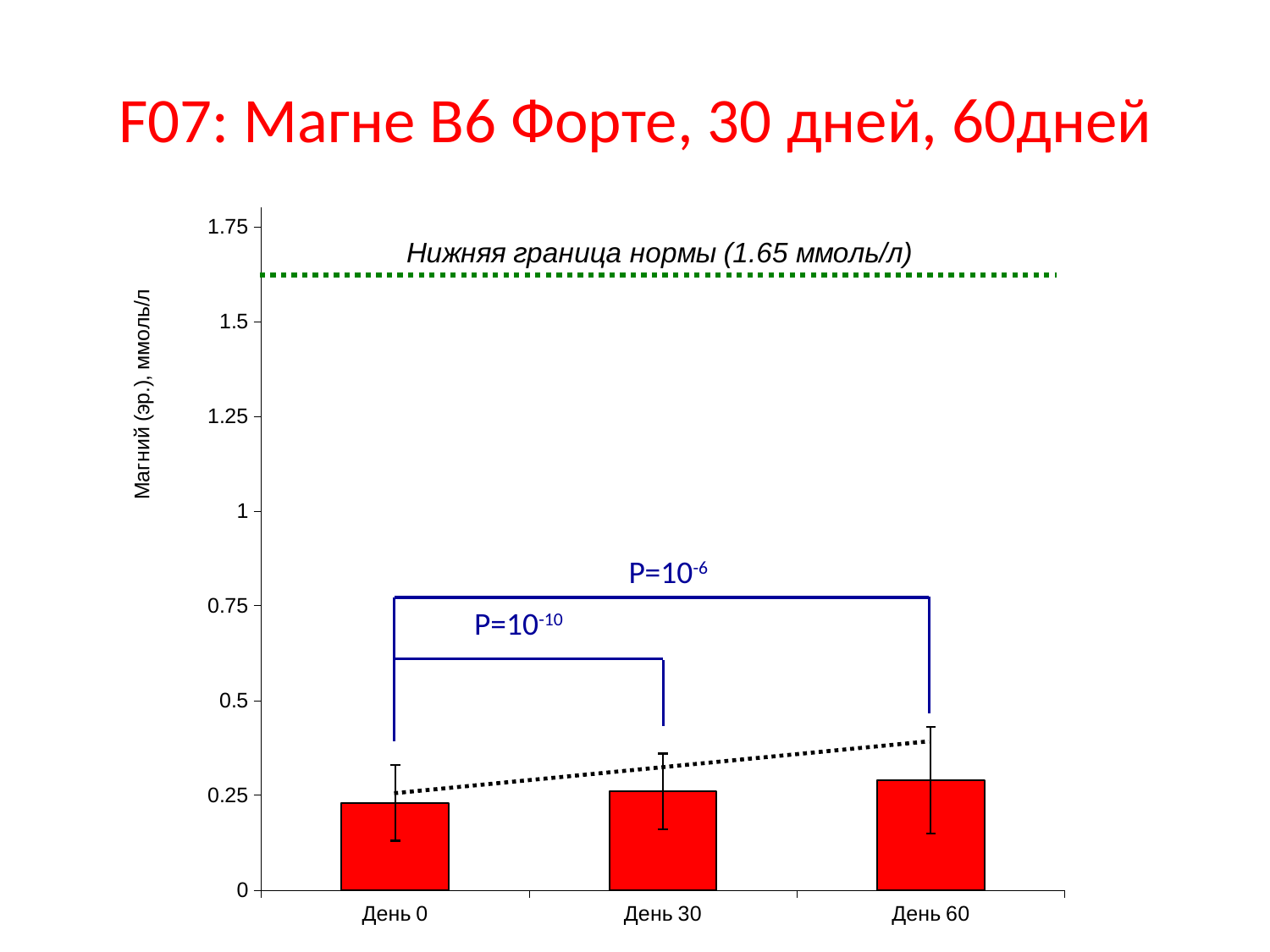
Which is larger, the value for День 0 or the value for День 60? День 60 What P value is shown between День 0 and День 60? P=10^-6 Is the value for День 60 greater or less than 0.5? less What is the y-axis label of the chart? Магний (эр.), ммоль/л What value is given for the lower limit of the norm (Нижняя граница нормы) on the chart? 1.65 ммоль/л Do the bar values rise or fall from День 0 to День 60? rise What kind of chart is shown on the slide? bar chart How many bars (categories) are plotted on the chart? 3 What is the title of the slide? F07: Магне В6 Форте, 30 дней, 60дней Is the value for День 30 greater or less than 1? less Is the value for День 0 greater or less than 0.25? less What P value is shown between День 0 and День 30? P=10^-10